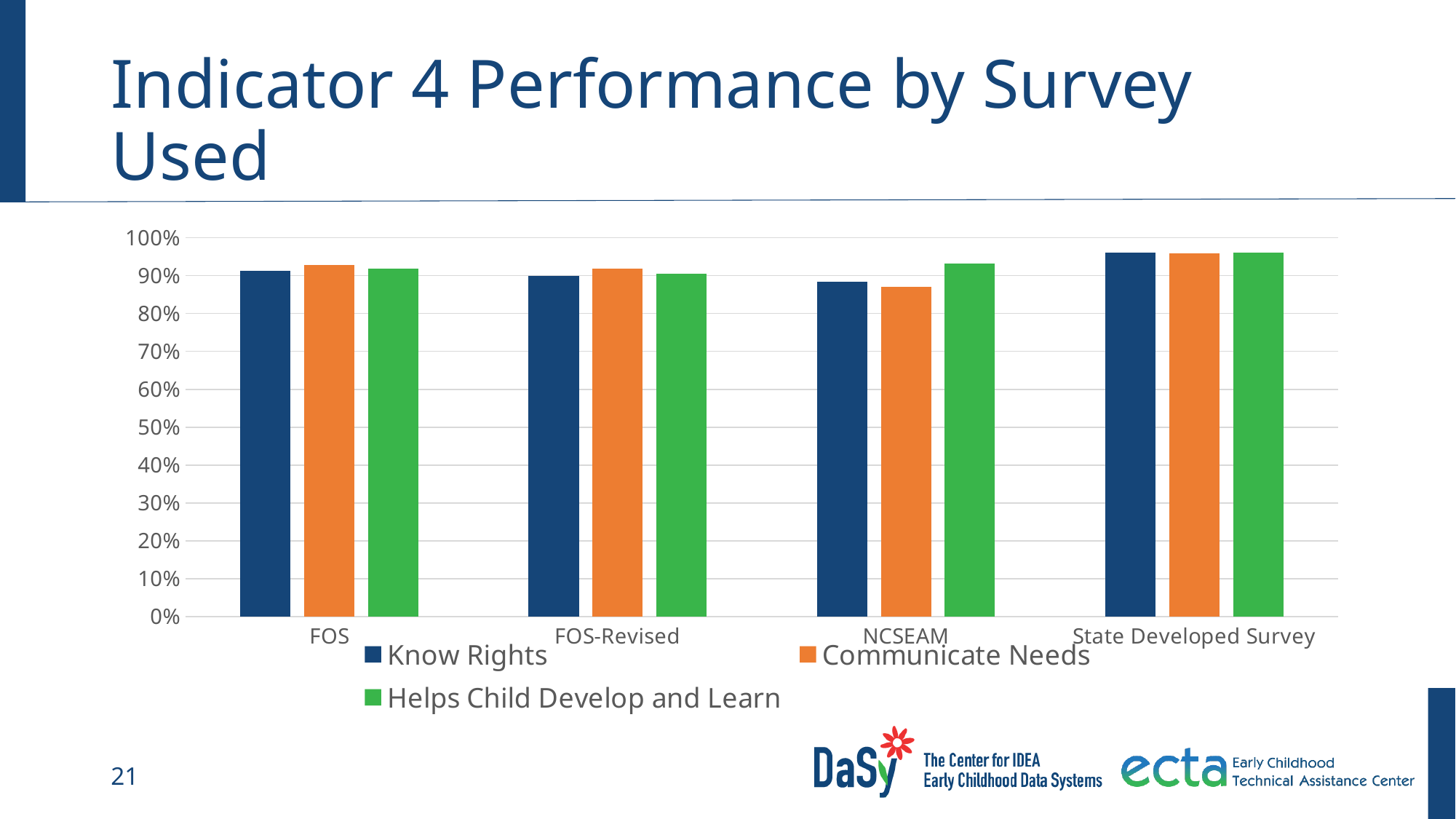
Is the value for Communicate Needs for FOS greater or less than 80%? greater What colour represents the Communicate Needs series in the legend? orange How many series does the legend list? 3 Is the value for Helps Child Develop and Learn for NCSEAM greater or less than 90%? greater Is the value for Communicate Needs for NCSEAM greater or less than 90%? less Which survey has the highest value for Know Rights? State Developed Survey What kind of chart is shown on the slide? bar chart Which survey has the lowest value for Communicate Needs? NCSEAM For NCSEAM, which is larger: Helps Child Develop and Learn or Communicate Needs? Helps Child Develop and Learn What is the title of the chart? Indicator 4 Performance by Survey Used How many survey categories are shown on the x axis? 4